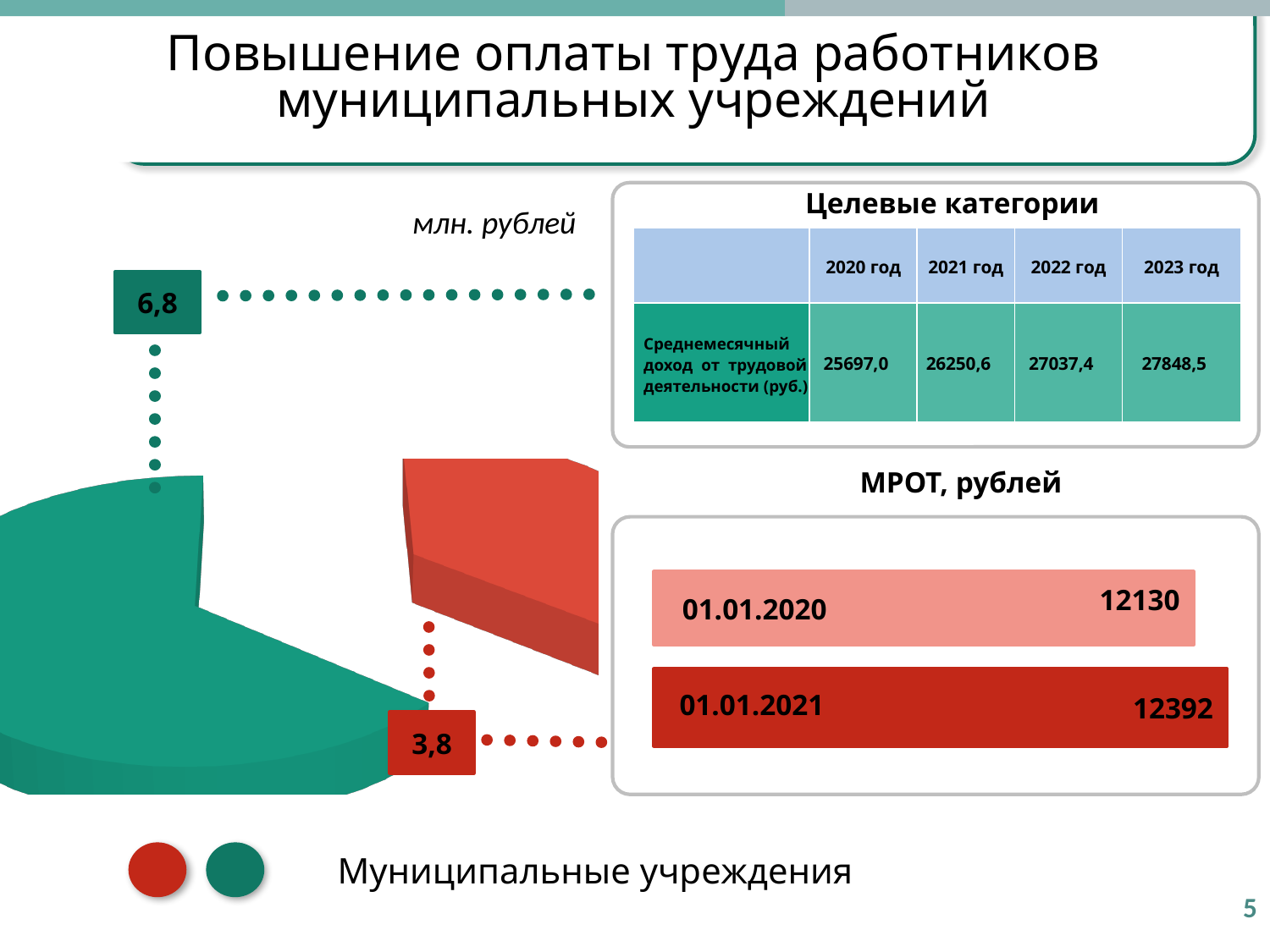
In the pie chart on the left, what value is labelled on the green slice? 6,8 What kind of chart is shown on the left side of the slide? pie chart In the МРОТ, рублей bar chart on the right, what is the value for 01.01.2020? 12130 In the pie chart on the left, what is the total of the two slice values? 10,6 In the pie chart on the left, which slice is larger, the green one or the red one? the green one In the МРОТ, рублей bar chart on the right, does the value rise or fall from 01.01.2020 to 01.01.2021? rise In the pie chart on the left, what value is labelled on the red slice? 3,8 What unit is stated above the pie chart on the left? млн. рублей How many slices does the pie chart on the left have? 2 In the pie chart on the left, what is the difference between the green slice value and the red slice value? 3,0 In the МРОТ, рублей bar chart on the right, by how much does the value for 01.01.2021 exceed the value for 01.01.2020? 262 In the МРОТ, рублей bar chart on the right, what is the value for 01.01.2021? 12392